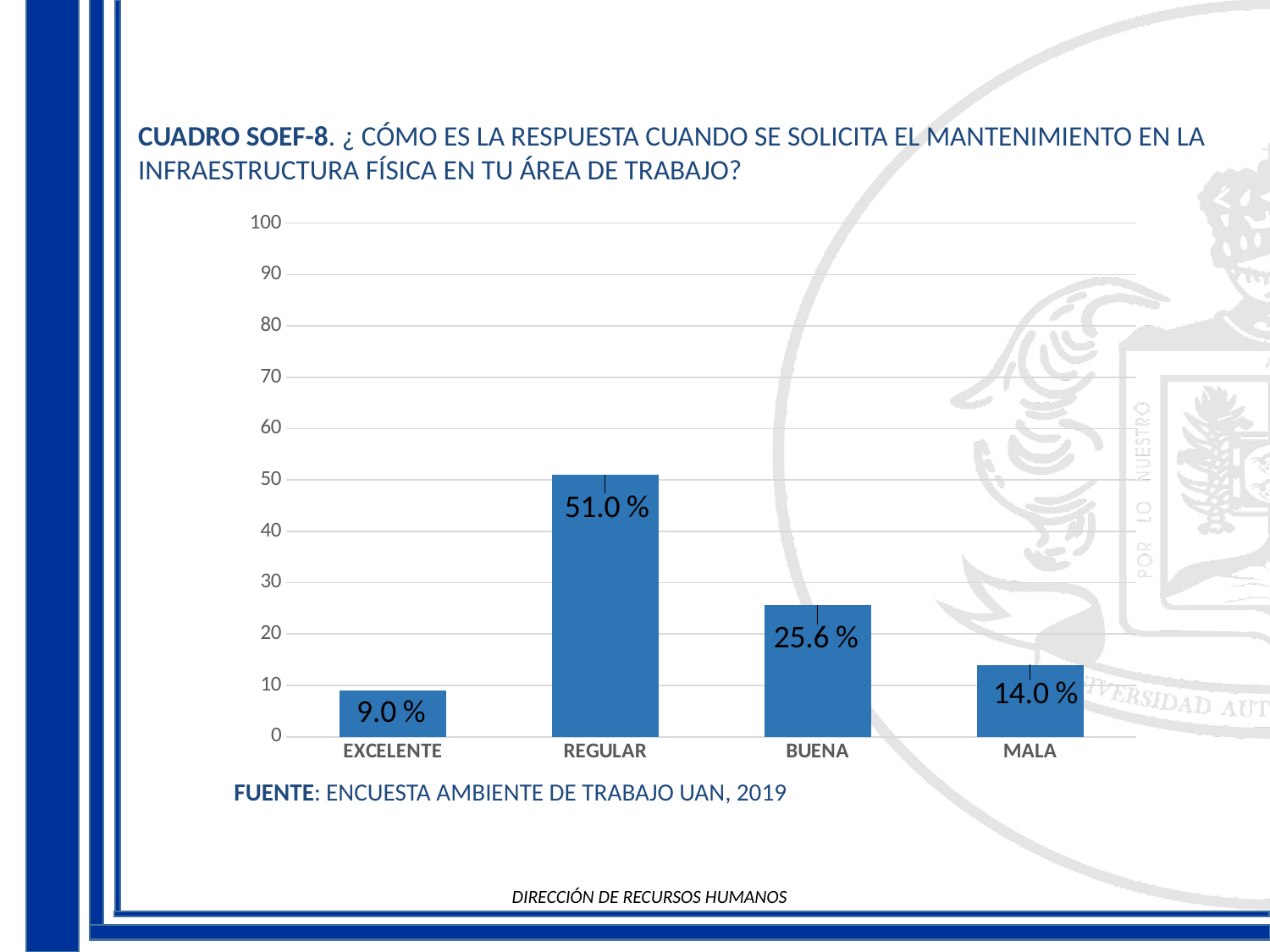
Which category has the highest value? REGULAR What is the value for REGULAR? 51.0 % What is the value for MALA? 14.0 % How many categories are shown on the x axis? 4 Which category has the lowest value? EXCELENTE What is the value for EXCELENTE? 9.0 % What source is cited below the chart? ENCUESTA AMBIENTE DE TRABAJO UAN, 2019 What is the difference between the values for REGULAR and BUENA? 25.4 % Which is larger, the value for BUENA or the value for MALA? BUENA What is the value for BUENA? 25.6 % What kind of chart is shown on the slide? bar chart Is the value for REGULAR greater or less than 50? greater